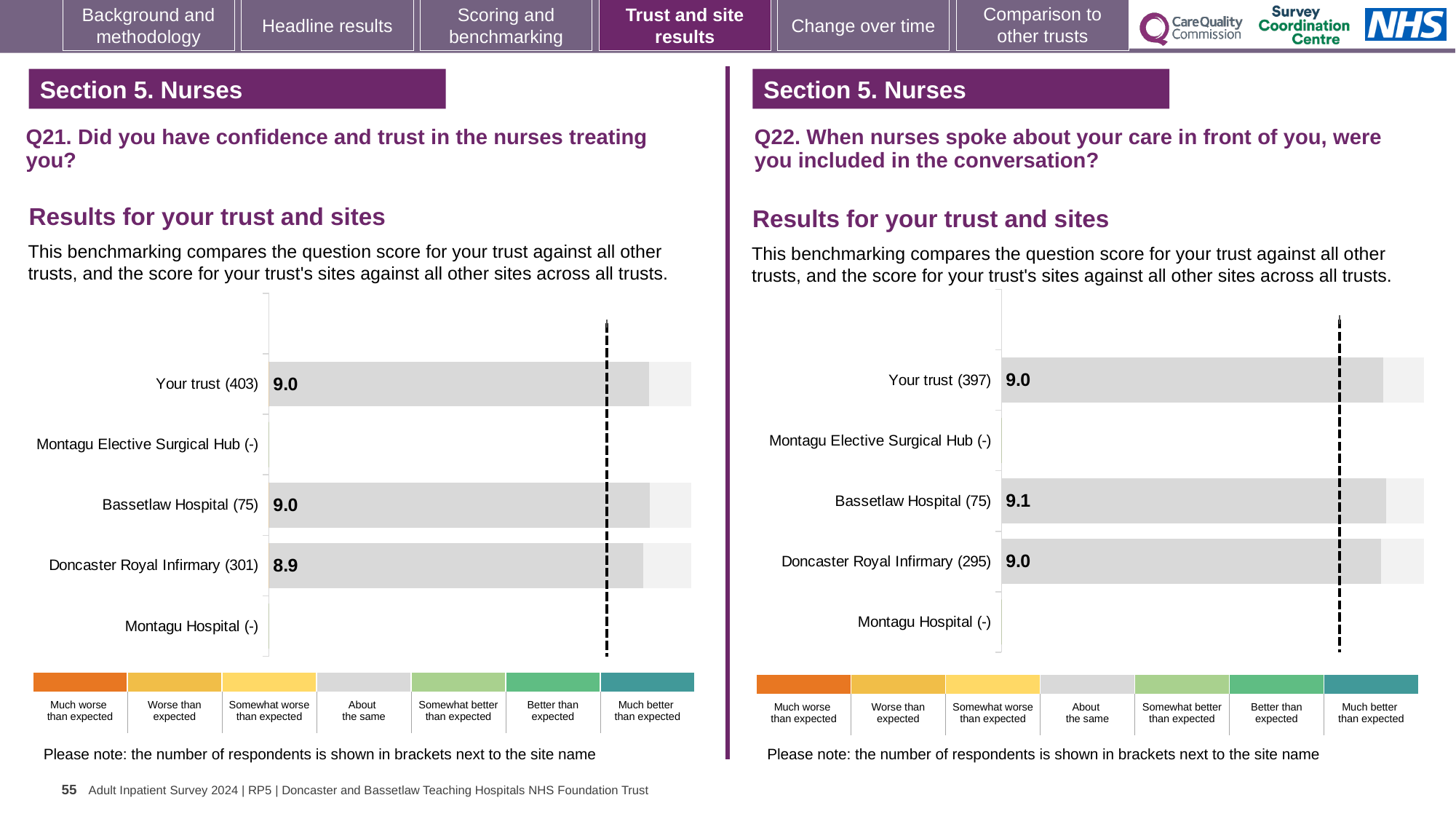
In the Q22 chart on the right, which site has the highest score? Bassetlaw Hospital (75) What kind of chart is used for the Q22 results on the right? Bar chart How many categories are listed on the y axis of the Q21 chart on the left? 5 In the Q21 chart on the left, what is the difference between the scores for Bassetlaw Hospital (75) and Doncaster Royal Infirmary (301)? 0.1 In the Q21 chart on the left, what is the score for Your trust (403)? 9.0 In the Q21 chart on the left, which site with a plotted score has the lowest score? Doncaster Royal Infirmary (301) In the Q22 chart on the right, what is the score for Bassetlaw Hospital (75)? 9.1 In the Q21 chart on the left, what is the score for Doncaster Royal Infirmary (301)? 8.9 In the Q21 chart on the left, what is the score for Bassetlaw Hospital (75)? 9.0 In the Q22 chart on the right, how many respondents are shown in brackets for Your trust? 397 In the Q22 chart on the right, what is the score for Doncaster Royal Infirmary (295)? 9.0 In the Q22 chart on the right, which has the higher score: Bassetlaw Hospital (75) or Doncaster Royal Infirmary (295)? Bassetlaw Hospital (75)